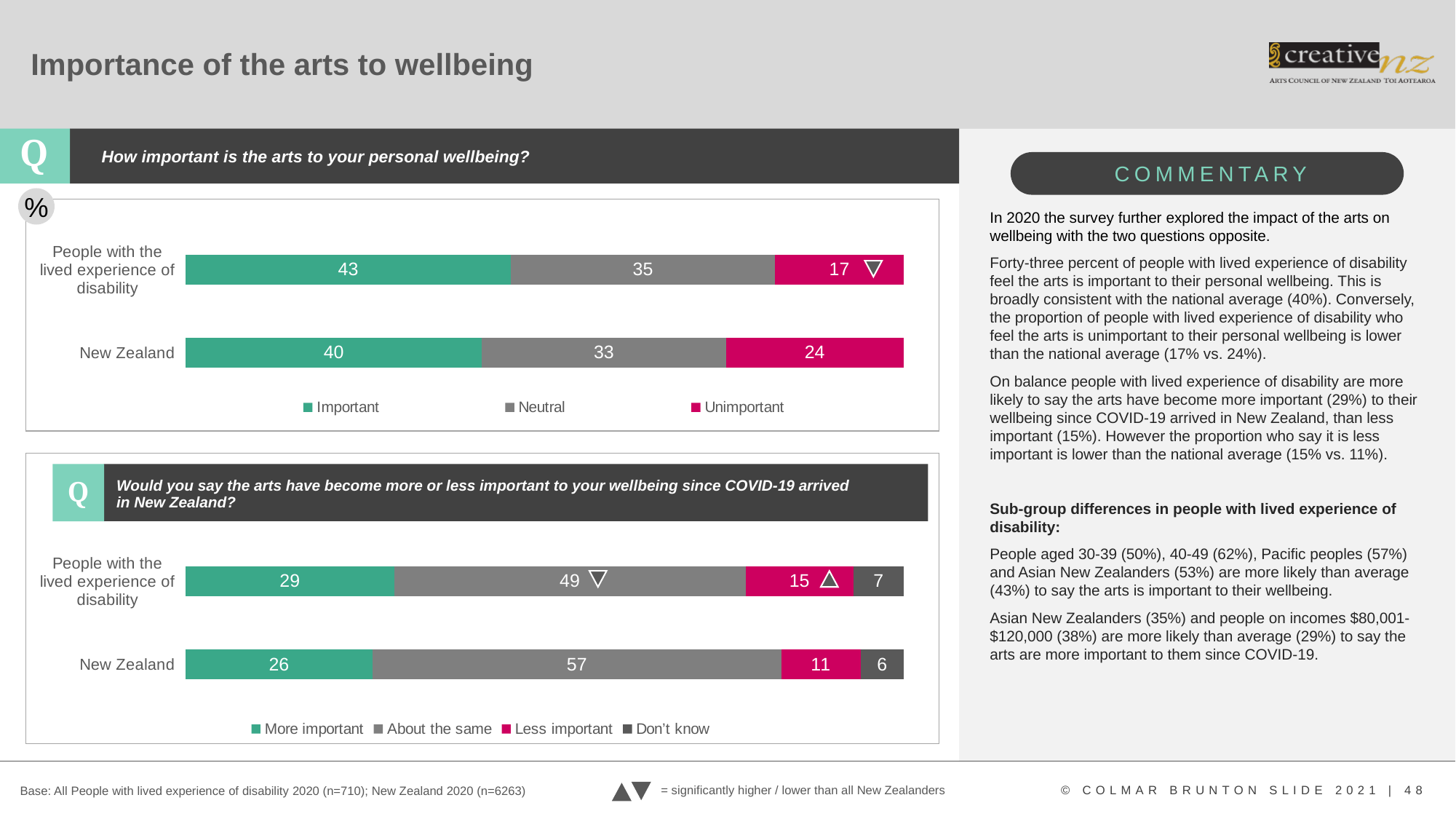
In the top chart (How important is the arts to your personal wellbeing?), what is the difference between the Unimportant values for New Zealand and people with the lived experience of disability? 7 In the bottom chart (Would you say the arts have become more or less important to your wellbeing since COVID-19 arrived in New Zealand?), which series has the largest value for New Zealand? About the same What type of chart is the top chart (How important is the arts to your personal wellbeing?)? Stacked bar chart In the bottom chart (Would you say the arts have become more or less important to your wellbeing since COVID-19 arrived in New Zealand?), what is the Don't know value for people with the lived experience of disability? 7 In the top chart (How important is the arts to your personal wellbeing?), which group has the higher Neutral value? People with the lived experience of disability In the top chart (How important is the arts to your personal wellbeing?), what percentage of people with the lived experience of disability say the arts are Important? 43 In the bottom chart (Would you say the arts have become more or less important to your wellbeing since COVID-19 arrived in New Zealand?), what is the difference between the More important values for people with the lived experience of disability and New Zealand? 3 In the bottom chart (Would you say the arts have become more or less important to your wellbeing since COVID-19 arrived in New Zealand?), what is the About the same value for New Zealand? 57 In the top chart (How important is the arts to your personal wellbeing?), what is the Unimportant value for New Zealand? 24 In the top chart (How important is the arts to your personal wellbeing?), how many series does the legend list? 3 In the bottom chart (Would you say the arts have become more or less important to your wellbeing since COVID-19 arrived in New Zealand?), how many series does the legend list? 4 In the bottom chart (Would you say the arts have become more or less important to your wellbeing since COVID-19 arrived in New Zealand?), what percentage of people with the lived experience of disability say Less important? 15